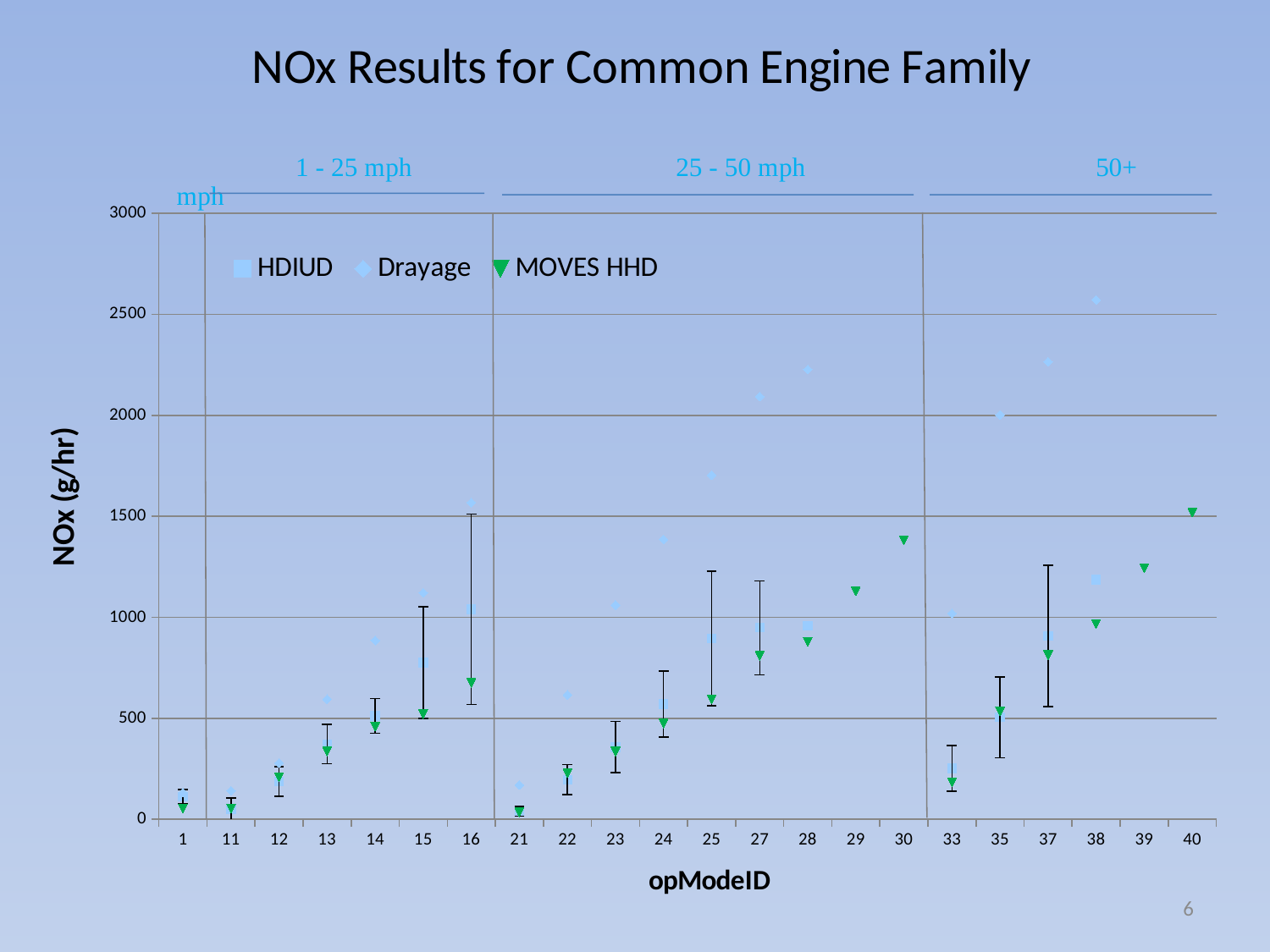
What speed range label is shown above the rightmost group of opModeIDs? 50+ Is the MOVES HHD value for opModeID 13 greater or less than 500? less Is the Drayage value for opModeID 28 greater or less than 2000? greater What is the title of the y axis? NOx (g/hr) Which opModeID has the highest MOVES HHD value? 40 What kind of chart is shown on the slide? scatter chart Which is larger, the Drayage value for opModeID 38 or for opModeID 28? opModeID 38 How many opModeID categories are shown on the x axis? 22 Which opModeID has the highest Drayage value? 38 Do the MOVES HHD values rise or fall from opModeID 21 to opModeID 30? rise Is the MOVES HHD value for opModeID 30 greater or less than 1000? greater How many series does the legend list? 3